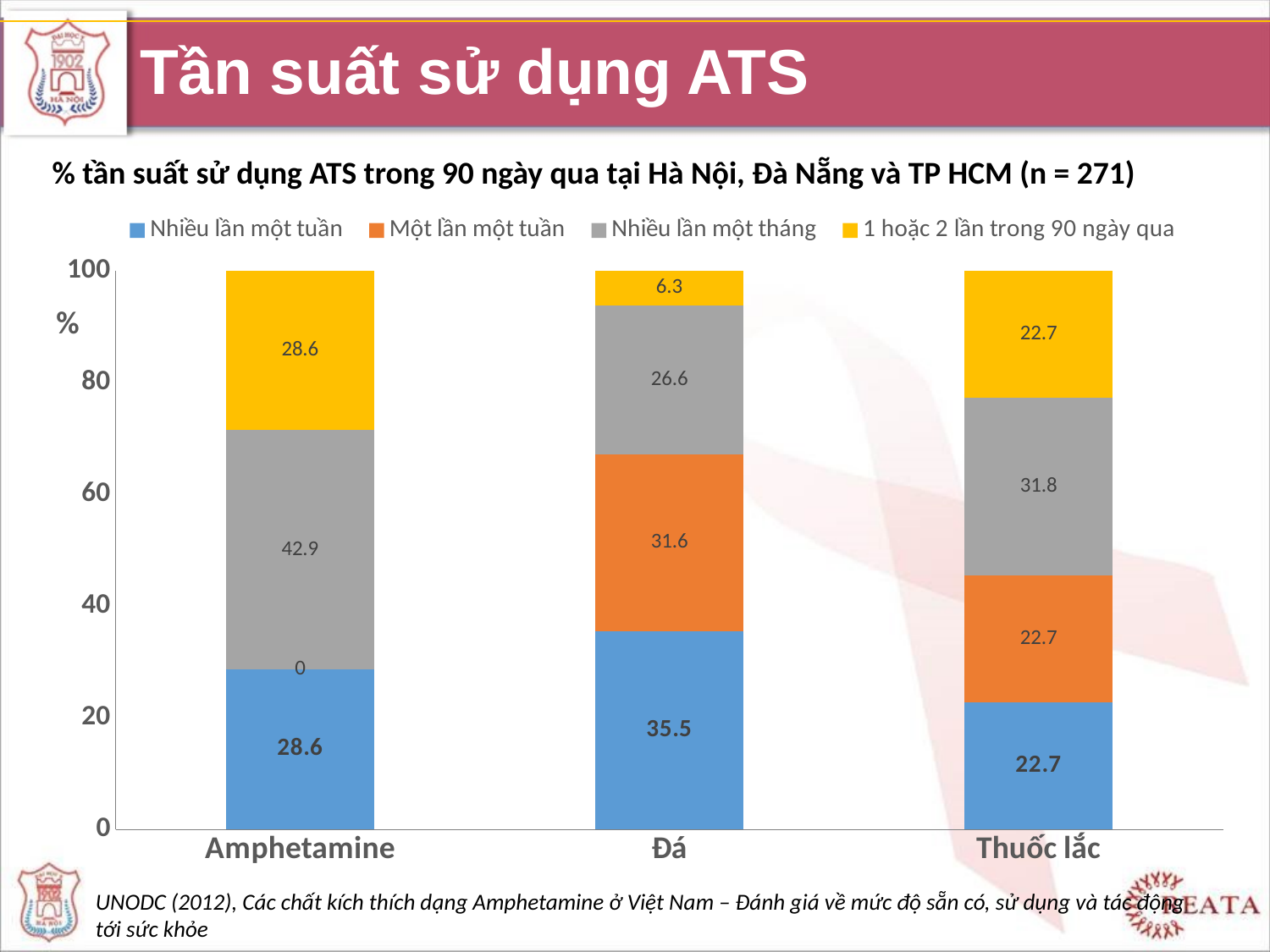
What is the value of 'Nhiều lần một tháng' for Amphetamine? 42.9 What type of chart is shown on the slide? stacked bar chart Which category has the highest value for 'Nhiều lần một tuần'? Đá How many series does the legend list? 4 What is the value of '1 hoặc 2 lần trong 90 ngày qua' for Đá? 6.3 What is the value of 'Nhiều lần một tuần' for Đá? 35.5 Which is larger: 'Một lần một tuần' for Đá or 'Một lần một tuần' for Thuốc lắc? Đá What is the value of 'Một lần một tuần' for Thuốc lắc? 22.7 How many categories are shown on the x axis? 3 What is the difference between the 'Nhiều lần một tháng' values for Amphetamine and Thuốc lắc? 11.1 Which category has the lowest value for '1 hoặc 2 lần trong 90 ngày qua'? Đá What is the value of 'Một lần một tuần' for Amphetamine? 0